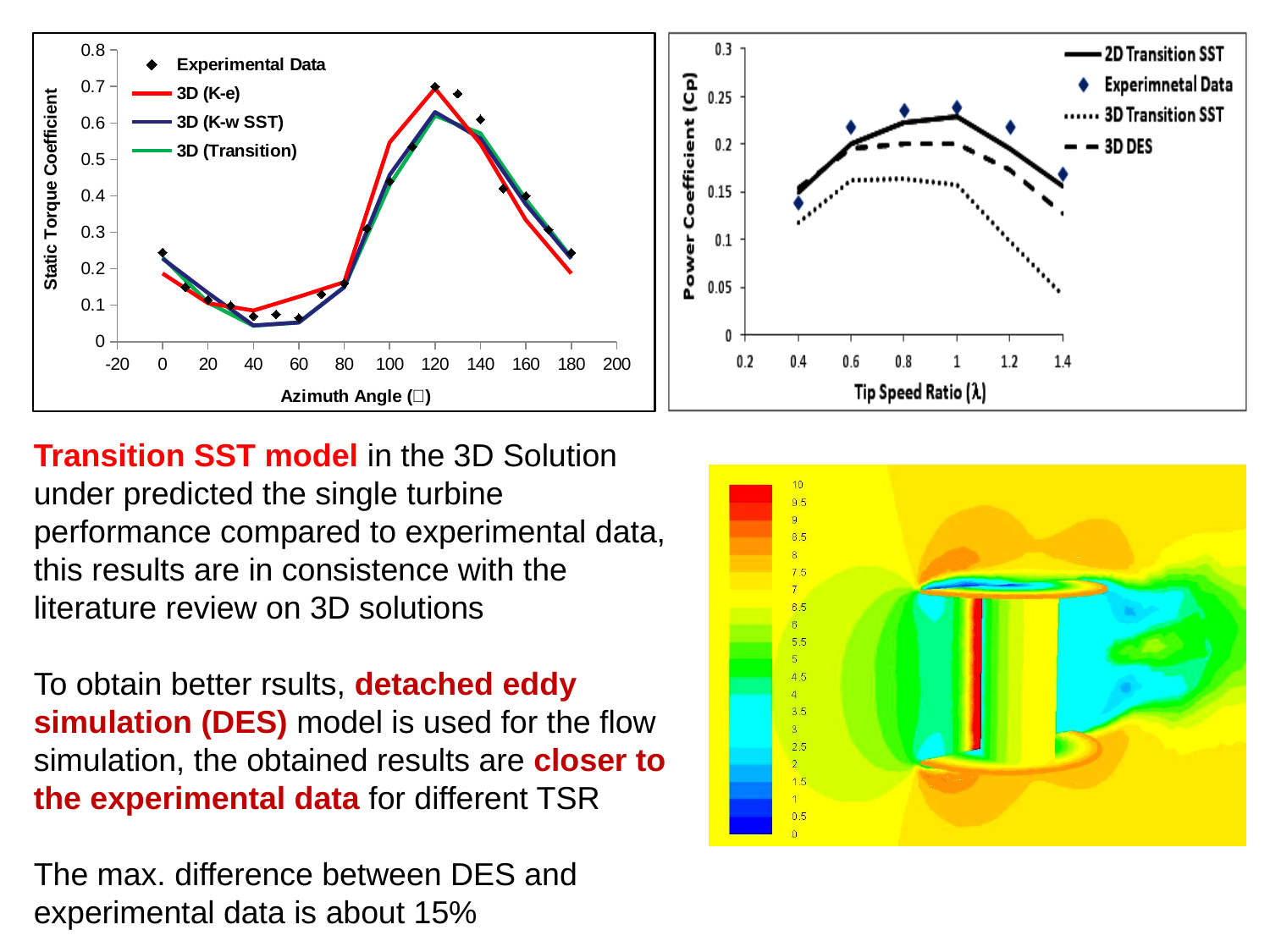
On the right chart, does the 3D Transition SST line rise or fall between Tip Speed Ratios of 1 and 1.4? Fall On the right chart, is the 2D Transition SST value at a Tip Speed Ratio of 1 greater or less than 0.2? greater On the right chart, at which Tip Speed Ratio is the Experimental Data value highest? 1 On the right chart, is the 3D Transition SST value at a Tip Speed Ratio of 1.2 greater or less than 0.15? less On the right chart, how many Experimental Data points are plotted? 6 What is the x-axis title of the right chart? Tip Speed Ratio (λ) What kind of chart is the left chart showing Static Torque Coefficient against Azimuth Angle? Line chart On the right chart (Power Coefficient vs Tip Speed Ratio), how many series does the legend list? 4 On the left chart, at which Azimuth Angle does the Experimental Data reach its highest value? 120 On the right chart, at which Tip Speed Ratio is the Experimental Data value lowest? 0.4 On the left chart, is the Experimental Data value at an Azimuth Angle of 120 greater or less than 0.6? greater On the left chart (Static Torque Coefficient vs Azimuth Angle), how many series does the legend list? 4